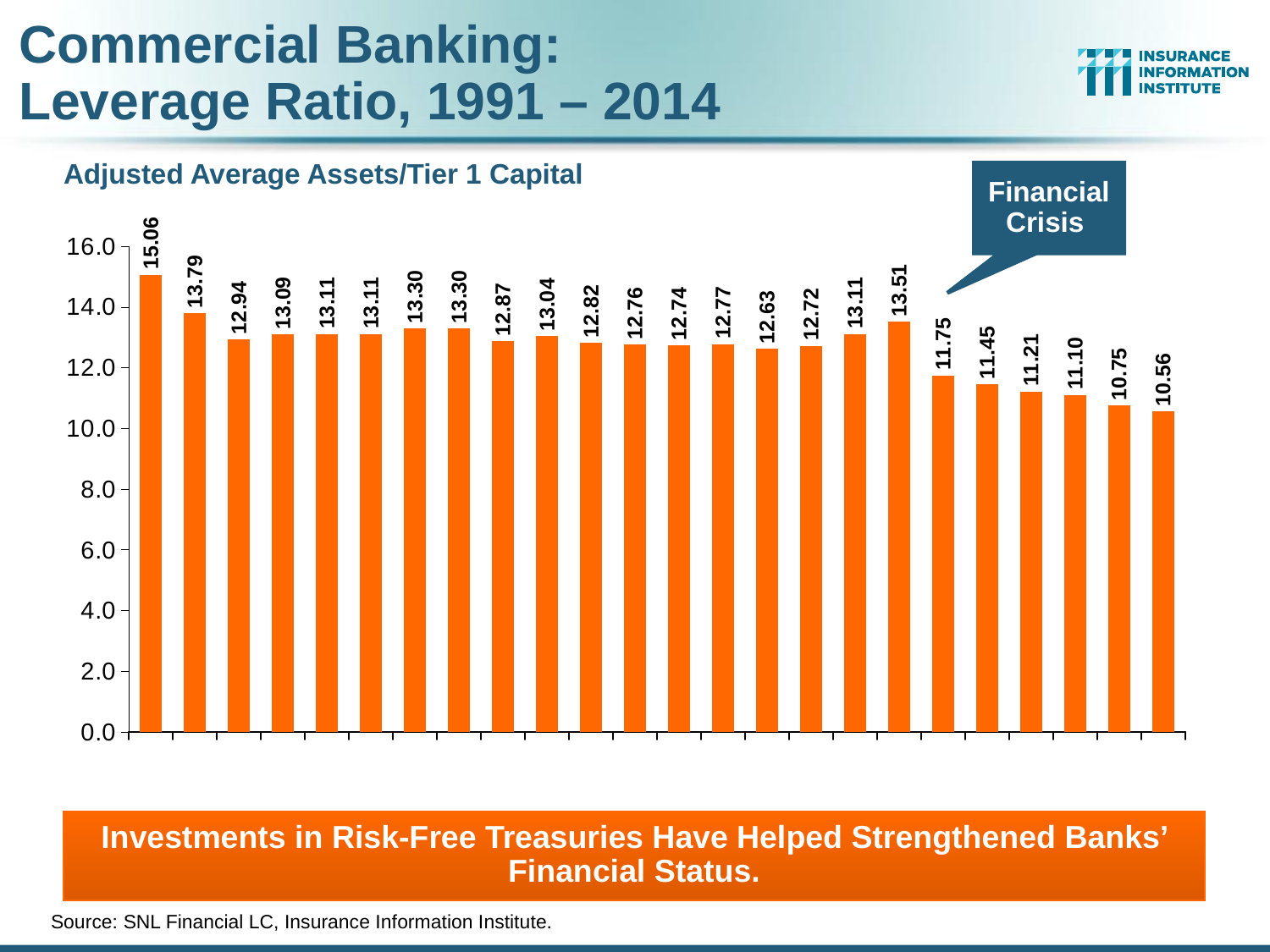
What kind of chart is shown on the slide? bar chart Which is larger, the second bar from the left or the third bar from the left? the second bar (13.79) What is the difference between the first bar (15.06) and the last bar (10.56)? 4.50 What is the lowest leverage ratio value shown in the chart? 10.56 What is the difference between the 13.51 bar and the 11.75 bar immediately to its right? 1.76 What is the value of the first (leftmost) bar in the chart? 15.06 What is the highest leverage ratio value shown in the chart? 15.06 Overall, do the values rise or fall from left to right across the chart? fall Is the value of the rightmost bar greater or less than 12.0? less How many bars are plotted in the chart? 24 What is the value of the bar that the 'Financial Crisis' callout points to? 11.75 What is the value of the last (rightmost) bar in the chart? 10.56